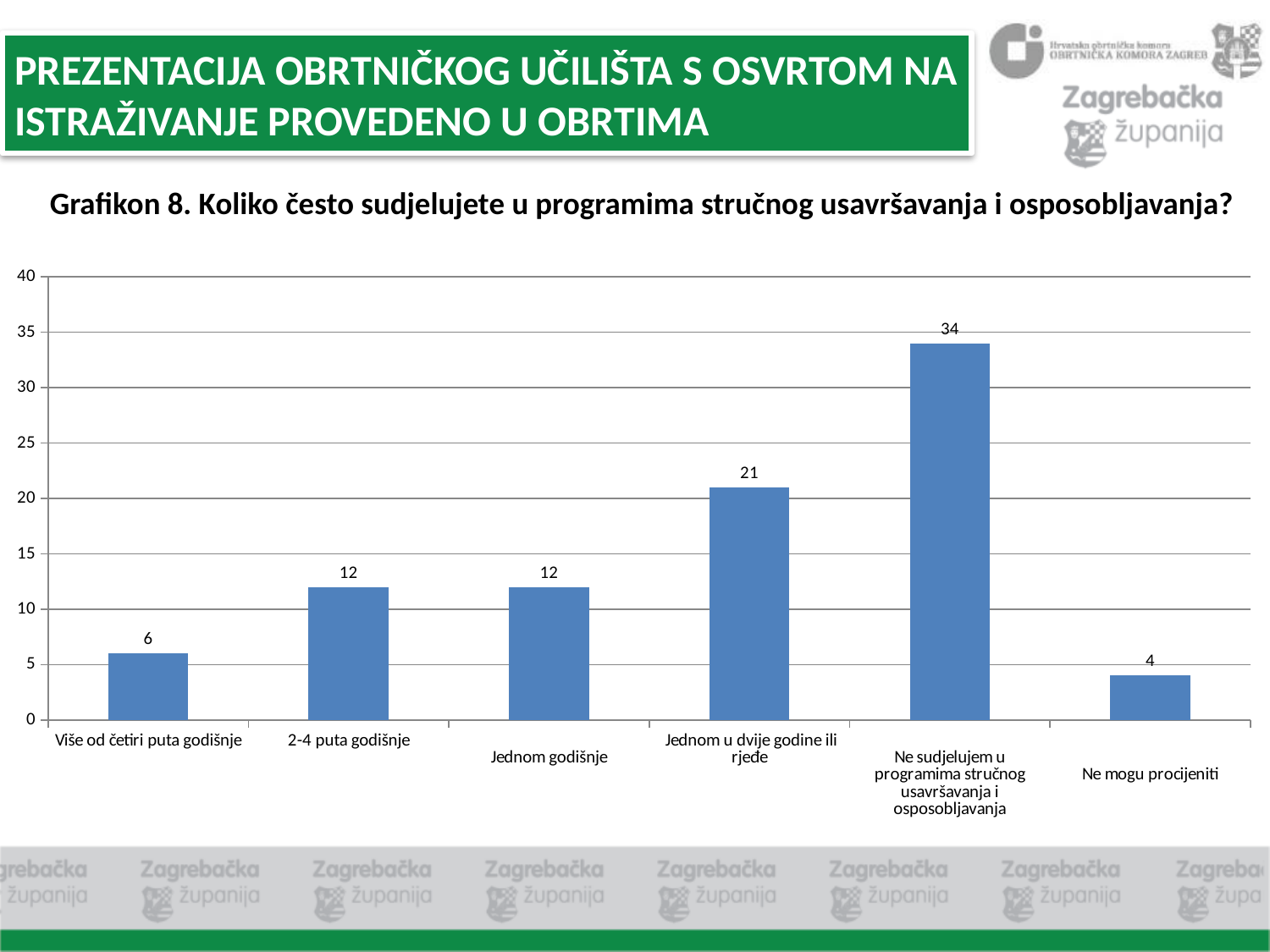
What kind of chart is shown on the slide? bar chart What is the difference between the values for "Ne sudjelujem u programima stručnog usavršavanja i osposobljavanja" and "Jednom u dvije godine ili rjeđe"? 13 What is the value for "Ne mogu procijeniti"? 4 Which is larger, the value for "2-4 puta godišnje" or the value for "Više od četiri puta godišnje"? 2-4 puta godišnje Which category has the lowest value? Ne mogu procijeniti What is the value for "Jednom u dvije godine ili rjeđe"? 21 Is the value for "Jednom u dvije godine ili rjeđe" greater or less than 20? greater What is the value for "Ne sudjelujem u programima stručnog usavršavanja i osposobljavanja"? 34 How many categories are shown on the x axis? 6 What is the title of the chart? Grafikon 8. Koliko često sudjelujete u programima stručnog usavršavanja i osposobljavanja? What is the value for "Više od četiri puta godišnje"? 6 Which category has the highest value? Ne sudjelujem u programima stručnog usavršavanja i osposobljavanja